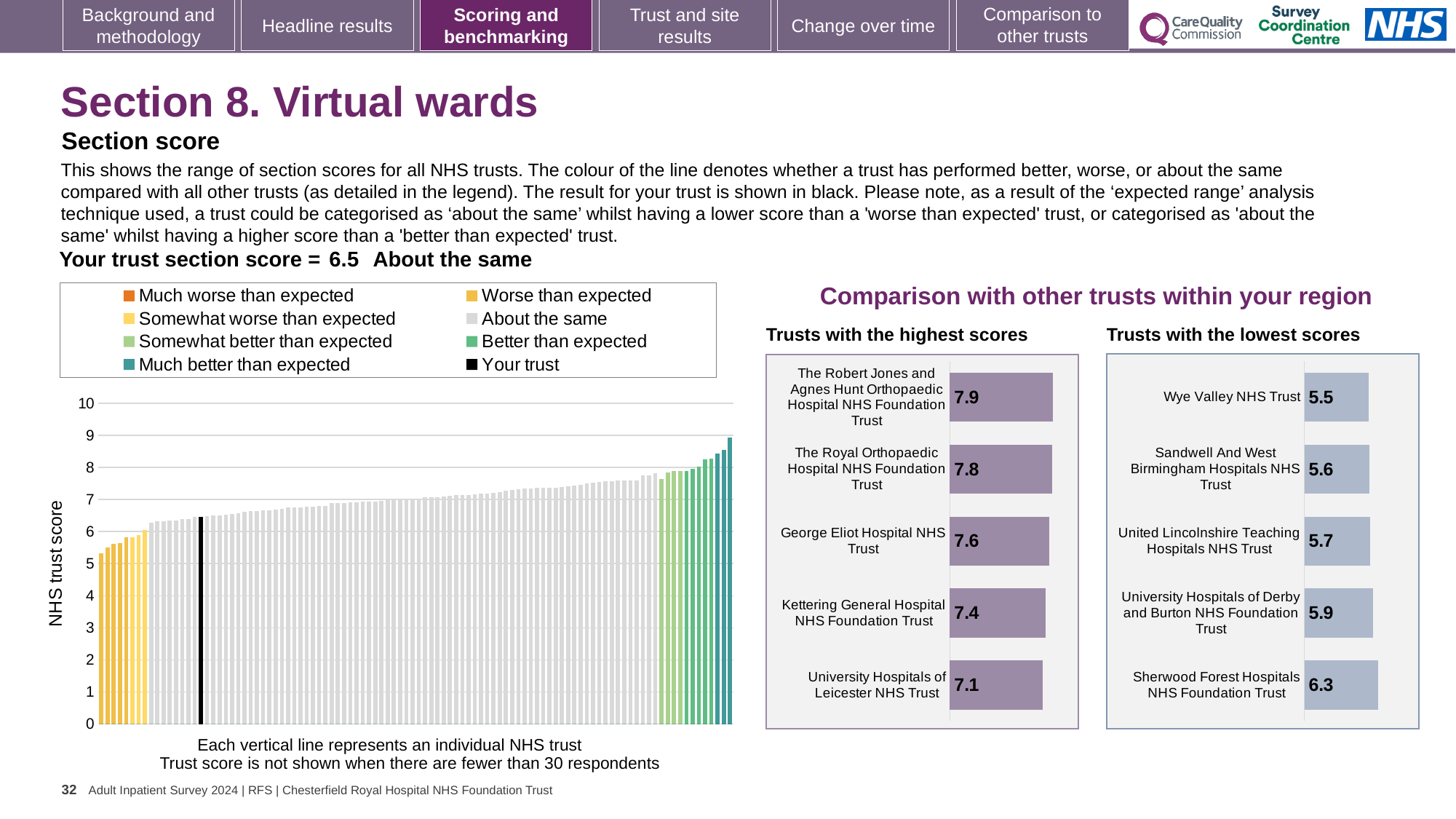
How many entries does the legend of the NHS trust score chart on the left list? 8 In the 'Trusts with the lowest scores' chart, which trust has the lowest score? Wye Valley NHS Trust In the 'Trusts with the lowest scores' chart, what is the score for Sandwell And West Birmingham Hospitals NHS Trust? 5.6 In the 'Trusts with the highest scores' chart, which trust has the highest score? The Robert Jones and Agnes Hunt Orthopaedic Hospital NHS Foundation Trust In the NHS trust score chart on the left, is the value of the highest bar greater or less than 8? greater In the 'Trusts with the highest scores' chart, what is the score for George Eliot Hospital NHS Trust? 7.6 In the 'Trusts with the highest scores' chart, how many trusts are shown? 5 In the 'Trusts with the highest scores' chart, what is the difference between the scores of The Robert Jones and Agnes Hunt Orthopaedic Hospital NHS Foundation Trust and University Hospitals of Leicester NHS Trust? 0.8 In the 'Trusts with the lowest scores' chart, which has the larger score: United Lincolnshire Teaching Hospitals NHS Trust or Sherwood Forest Hospitals NHS Foundation Trust? Sherwood Forest Hospitals NHS Foundation Trust In the NHS trust score chart on the left, what is the section score for your trust? 6.5 In the NHS trust score chart on the left, do the trust scores rise or fall from left to right? rise In the 'Trusts with the lowest scores' chart, what is the difference between the scores of Sherwood Forest Hospitals NHS Foundation Trust and Wye Valley NHS Trust? 0.8